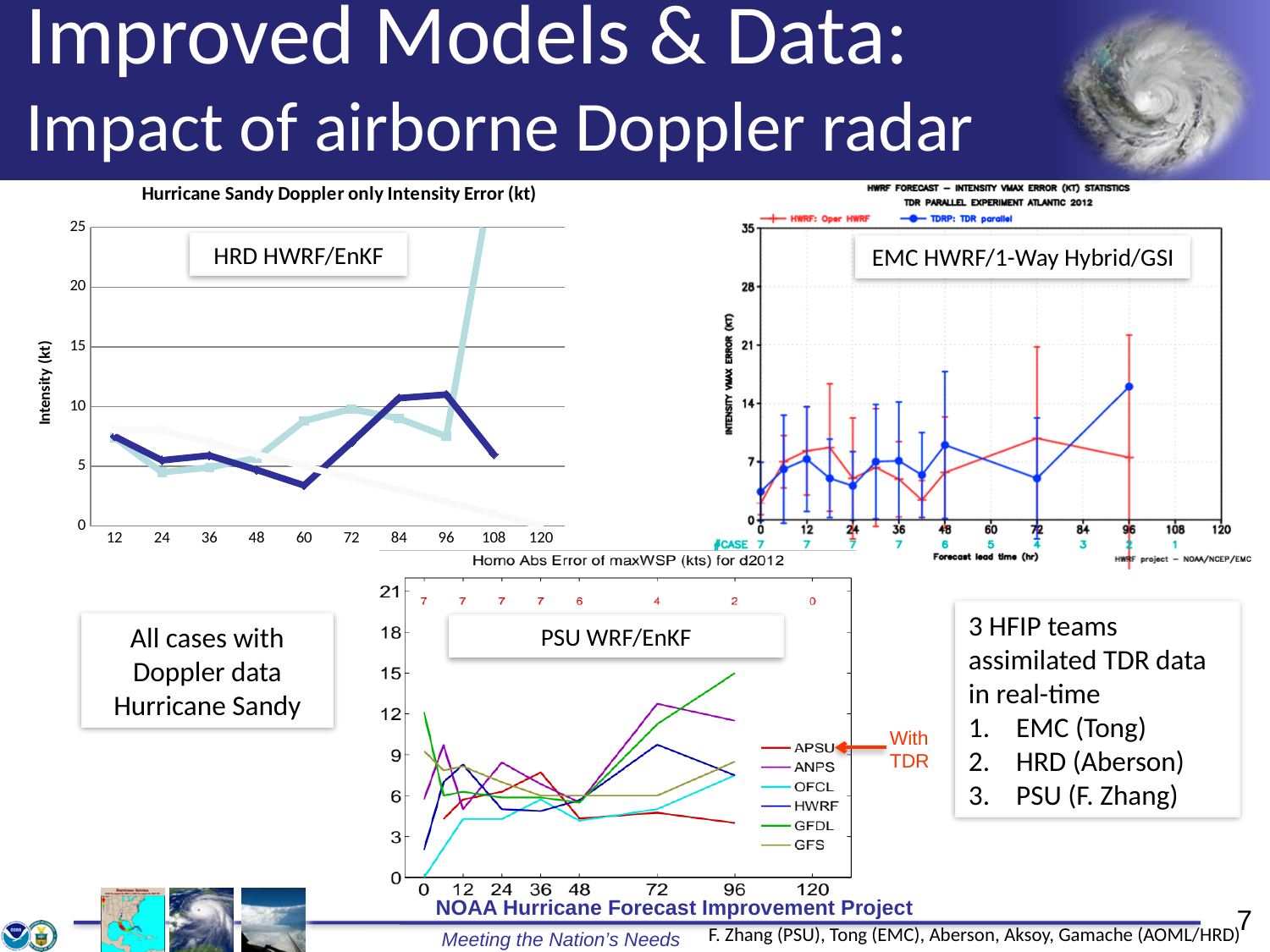
In the bottom chart 'Homo Abs Error of maxWSP (kts) for d2012', is the GFDL value at 96 hours greater or less than 12? greater What kind of chart is the top-left chart titled 'Hurricane Sandy Doppler only Intensity Error (kt)'? line chart In the top-right chart 'HWRF FORECAST – INTENSITY VMAX ERROR (KT) STATISTICS', how many series does the legend list? 2 In the bottom chart 'Homo Abs Error of maxWSP (kts) for d2012', how many series does the legend list? 6 In the top-left chart 'Hurricane Sandy Doppler only Intensity Error (kt)', is the value of the dark blue line at 60 hours greater or less than 5? less In the top-right chart 'HWRF FORECAST – INTENSITY VMAX ERROR (KT) STATISTICS', how many cases (#CASE) are listed at 96 hours? 2 In the top-right chart 'HWRF FORECAST – INTENSITY VMAX ERROR (KT) STATISTICS', which series has the larger value at 48 hours, HWRF: Oper HWRF or TDRP: TDR parallel? TDRP: TDR parallel In the bottom chart 'Homo Abs Error of maxWSP (kts) for d2012', which series has the lowest value at 96 hours? APSU In the bottom chart 'Homo Abs Error of maxWSP (kts) for d2012', which series has the highest value at 96 hours? GFDL In the top-right chart 'HWRF FORECAST – INTENSITY VMAX ERROR (KT) STATISTICS', is the TDRP: TDR parallel value at 96 hours greater or less than 14? greater What is the y-axis label of the top-left chart 'Hurricane Sandy Doppler only Intensity Error (kt)'? Intensity (kt) In the bottom chart 'Homo Abs Error of maxWSP (kts) for d2012', what is the case count printed in red above 72 hours? 4